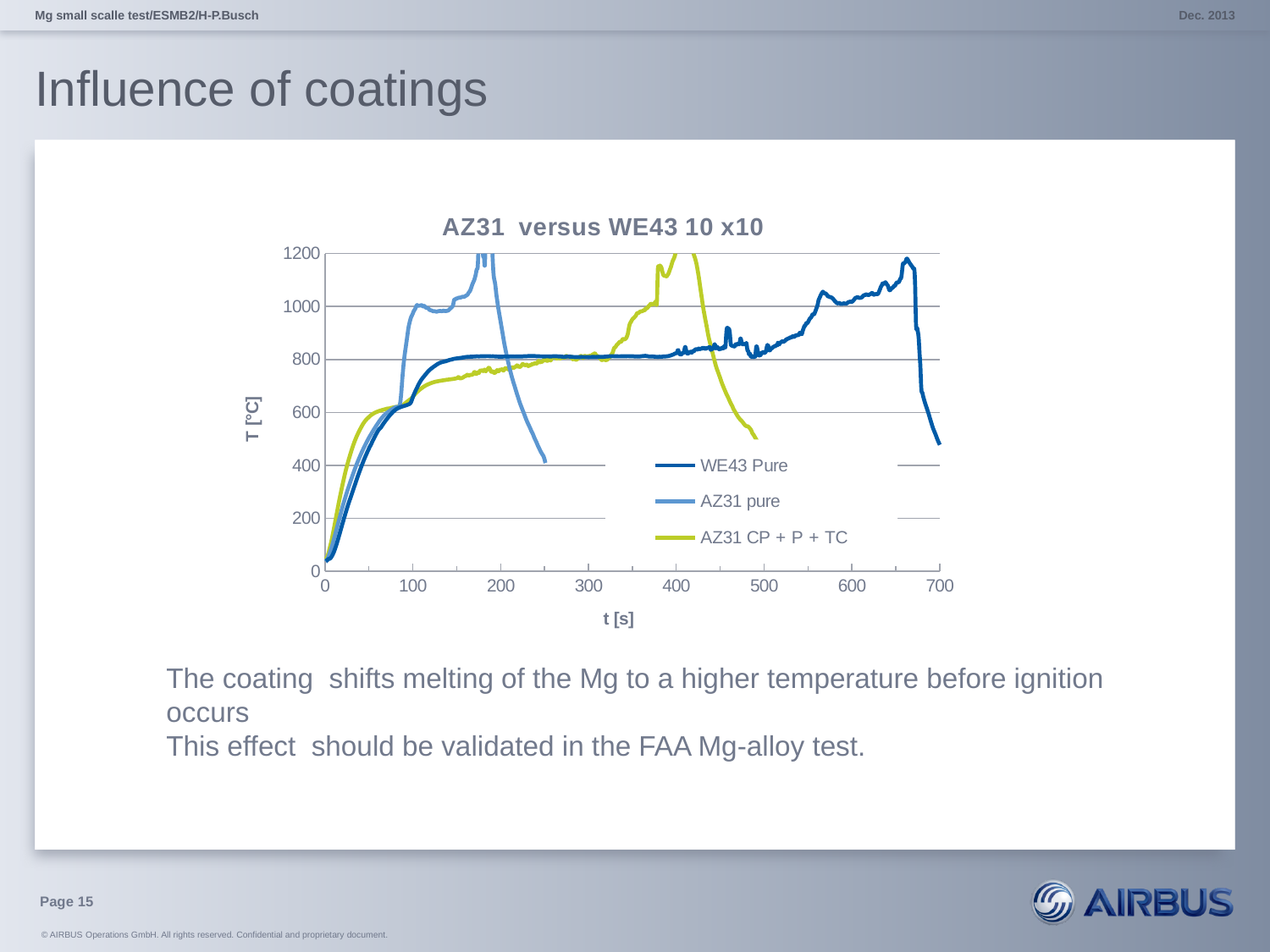
Which series reaches 1200 °C first (at the smallest t)? AZ31 pure Is the value of WE43 Pure at t = 300 s greater or less than 600 °C? greater Does the AZ31 pure series rise or fall between t = 200 s and t = 250 s? fall Which series is drawn in green (yellow-green)? AZ31 CP + P + TC What kind of chart is shown on the slide? line chart Is the value of AZ31 CP + P + TC at t = 400 s greater or less than 1000 °C? greater How many series does the legend list? 3 Does the WE43 Pure series rise or fall between t = 0 s and t = 100 s? rise What is the title of the chart? AZ31 versus WE43 10 x10 Which series ends at the smallest value of t? AZ31 pure Which series extends to the largest value of t on the x axis? WE43 Pure